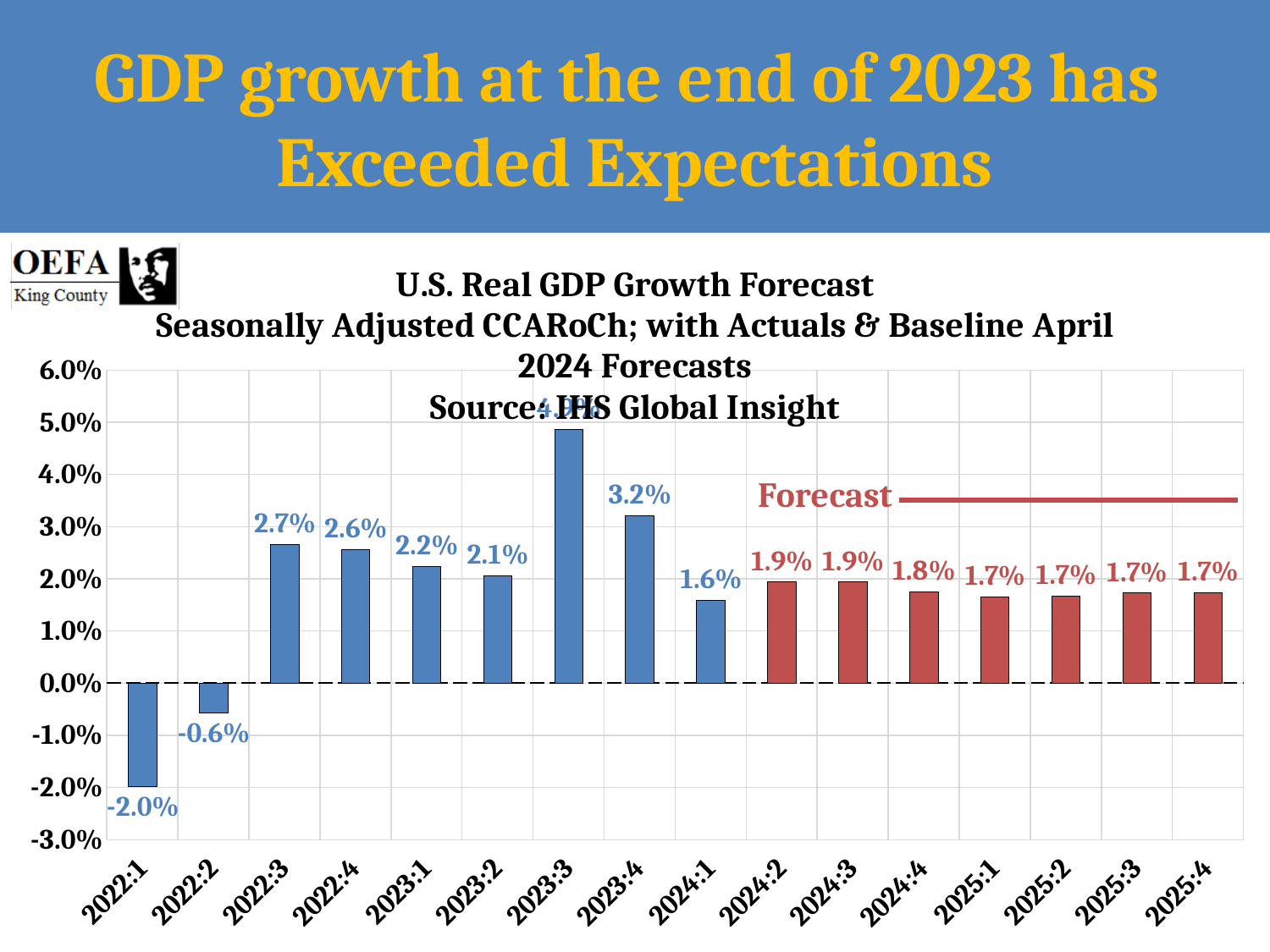
What is the value for 2024:1? 1.6% What is the value for 2023:4? 3.2% What kind of chart is this? bar chart Is the value for 2023:3 greater or less than 4.0%? greater Which quarter has the lowest value? 2022:1 What is the value for 2025:4? 1.7% Which is larger, the value for 2022:3 or the value for 2022:4? 2022:3 What is the value for 2022:1? -2.0% How many quarters are shown on the x axis? 16 What is the source of the data shown in the chart? IHS Global Insight Which quarter has the highest value? 2023:3 What is the difference between the values for 2023:4 and 2024:1? 1.6%